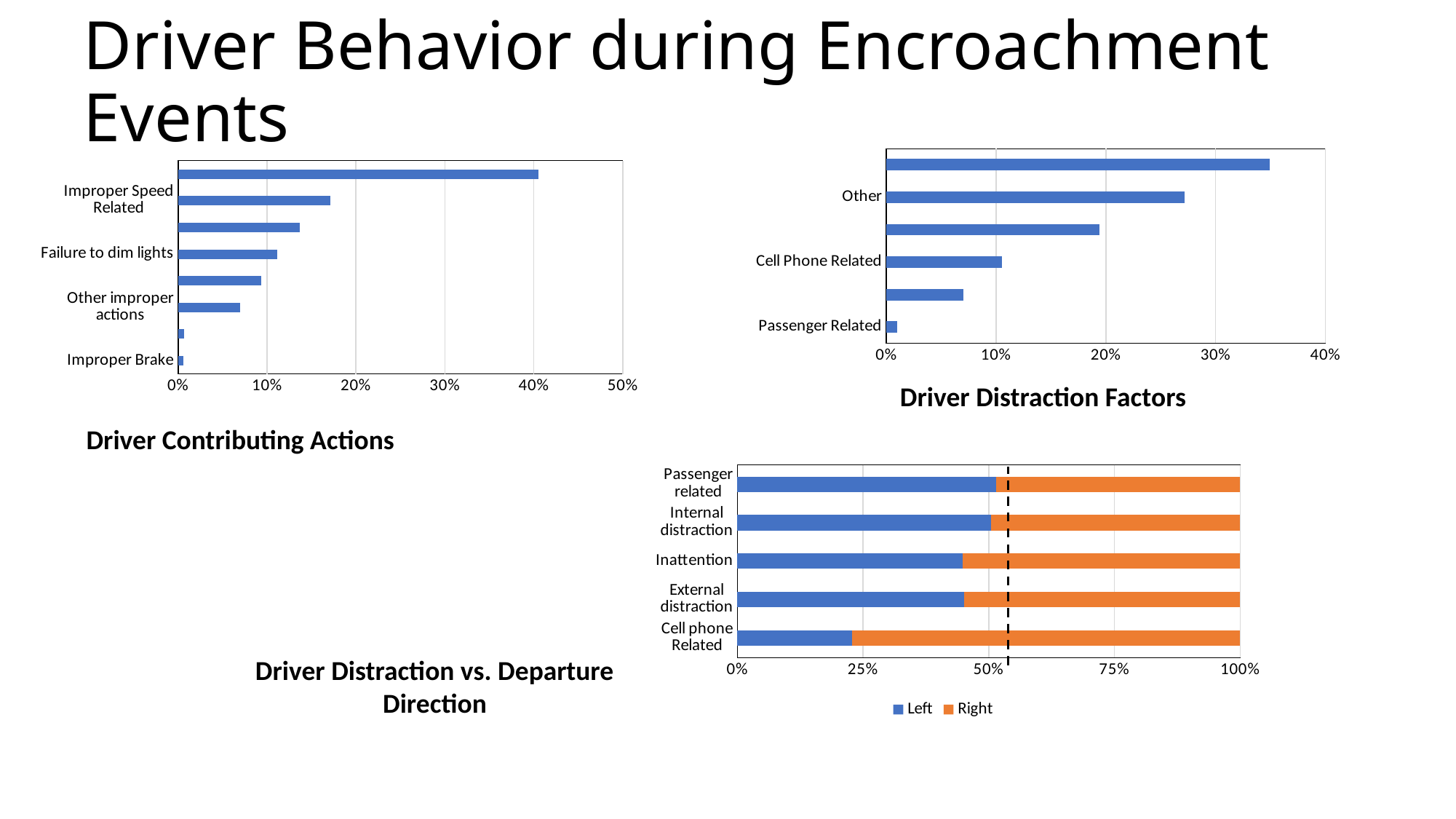
In the Driver Contributing Actions chart, is the value for Other improper actions greater or less than 10%? less In the Driver Contributing Actions chart, is the value for Improper Speed Related greater or less than 20%? less How many bars are plotted in the Driver Contributing Actions chart? 8 In the Driver Distraction vs. Departure Direction chart, which category has the smallest Left share? Cell phone Related In the Driver Distraction Factors chart, is the value for Passenger Related greater or less than 10%? less How many categories are shown in the Driver Distraction vs. Departure Direction chart? 5 In the Driver Contributing Actions chart, which is larger, the value for Failure to dim lights or the value for Improper Brake? Failure to dim lights How many series does the legend list in the Driver Distraction vs. Departure Direction chart? 2 In the Driver Distraction Factors chart, which is larger, the value for Cell Phone Related or the value for Other? Other What kind of chart is the Driver Distraction Factors chart? bar chart